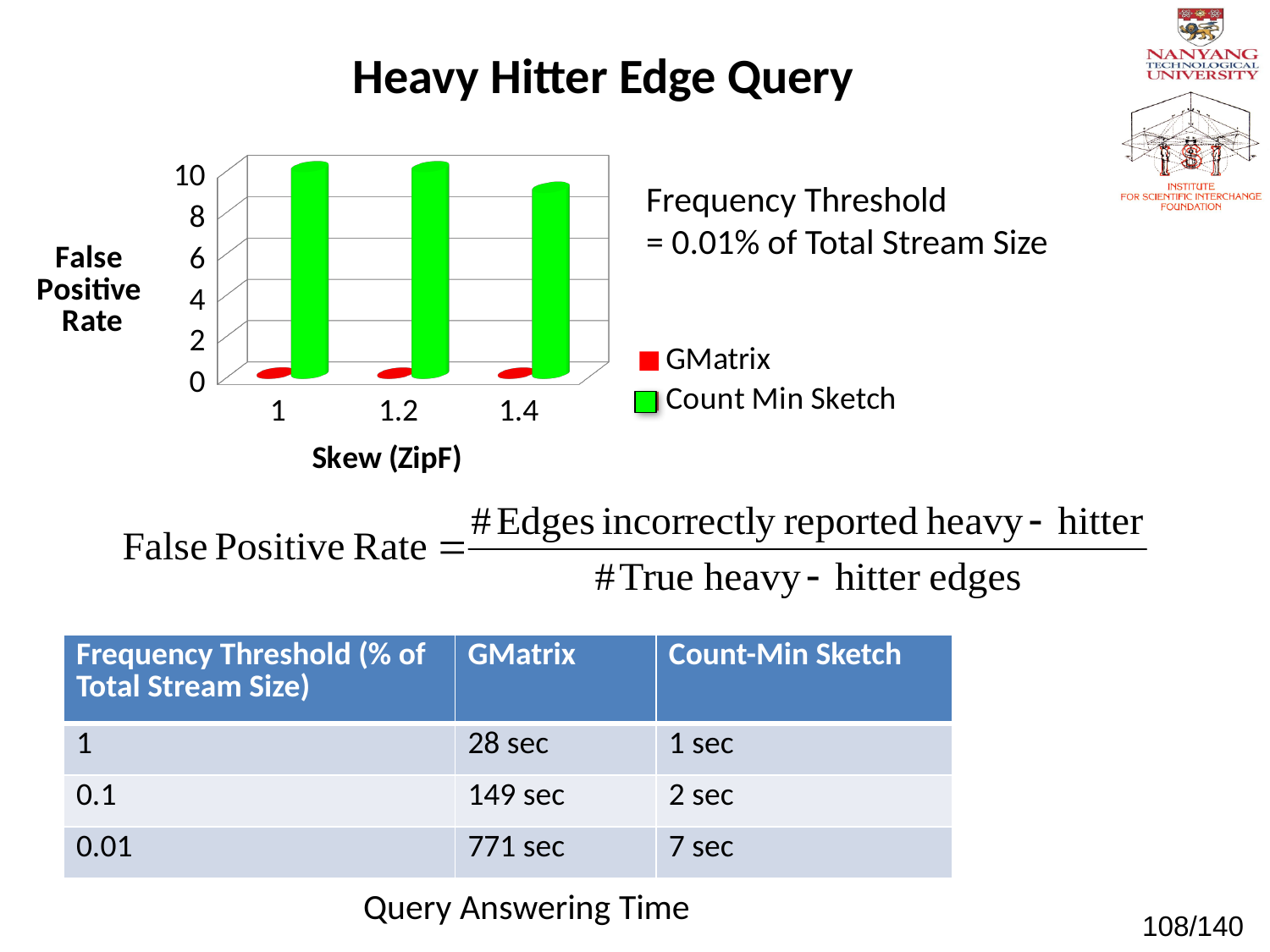
How many skew categories are shown on the x axis of the chart? 3 Is the false positive rate for Count Min Sketch at skew 1.4 greater or less than 8? greater What is the title of the x axis of the chart? Skew (ZipF) Which colour represents Count Min Sketch in the chart legend? green At which skew value is the Count Min Sketch false positive rate lowest? 1.4 Is the false positive rate for GMatrix at skew 1.2 greater or less than 2? less Does the Count Min Sketch false positive rate rise or fall from skew 1.2 to skew 1.4? fall What kind of chart is shown on the slide? bar chart Which series has the higher false positive rate at skew 1: GMatrix or Count Min Sketch? Count Min Sketch How many series does the chart legend list? 2 Which series has the lower false positive rate at skew 1.4: GMatrix or Count Min Sketch? GMatrix